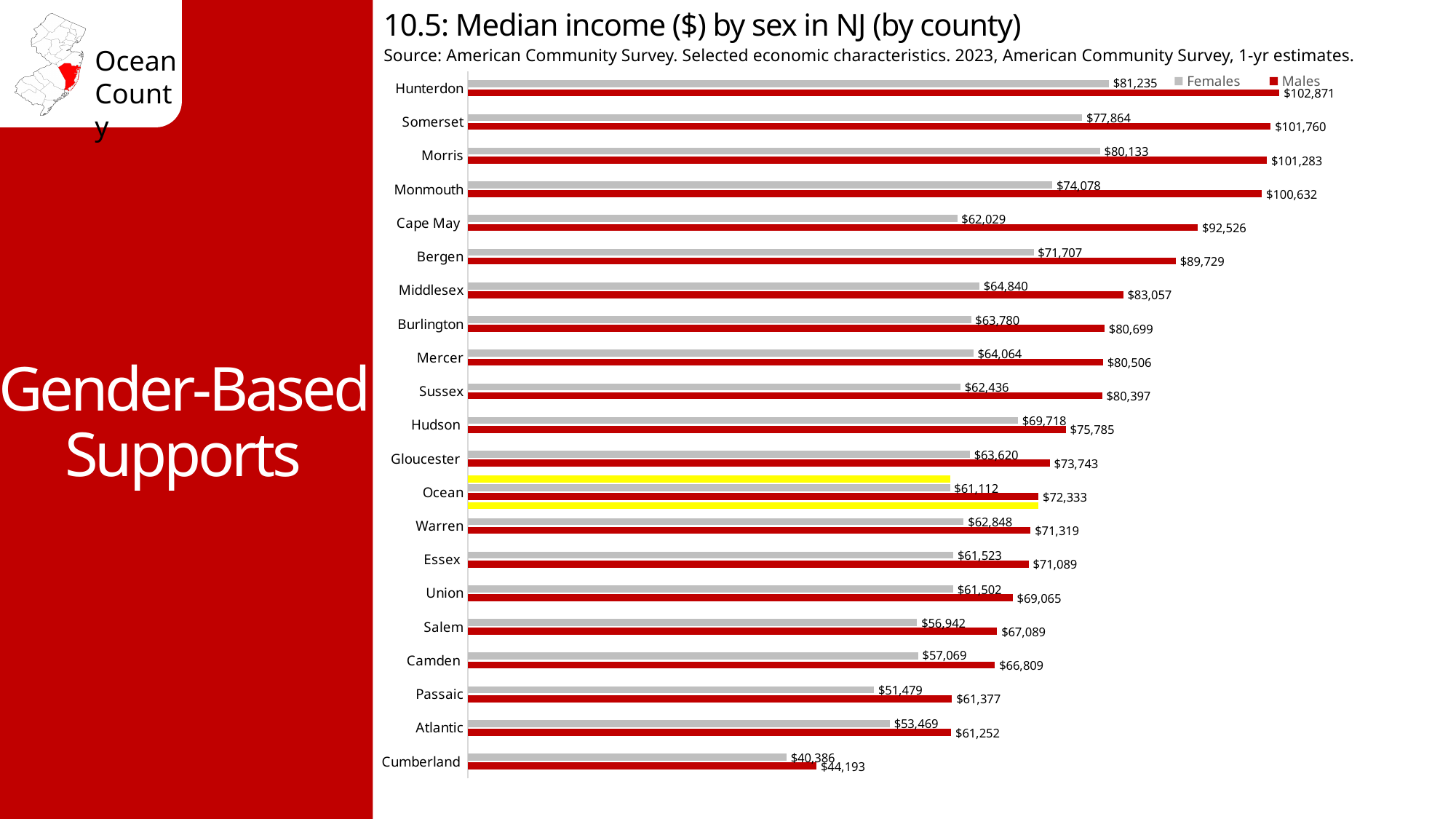
What type of chart is shown on the slide? Bar chart Which county has the lowest median income for females? Cumberland How many counties are shown in the chart? 21 What is the median income for males in Ocean County? $72,333 Which county has the highest median income for males? Hunterdon What is the difference between male and female median income in Ocean County? $11,221 What is the median income for females in Bergen County? $71,707 Which is higher: the female median income in Hudson County or in Monmouth County? Monmouth County Which county's bars are highlighted in yellow on the chart? Ocean How many series does the legend list? 2 What is the median income for females in Ocean County? $61,112 What is the difference between male and female median income in Hunterdon County? $21,636